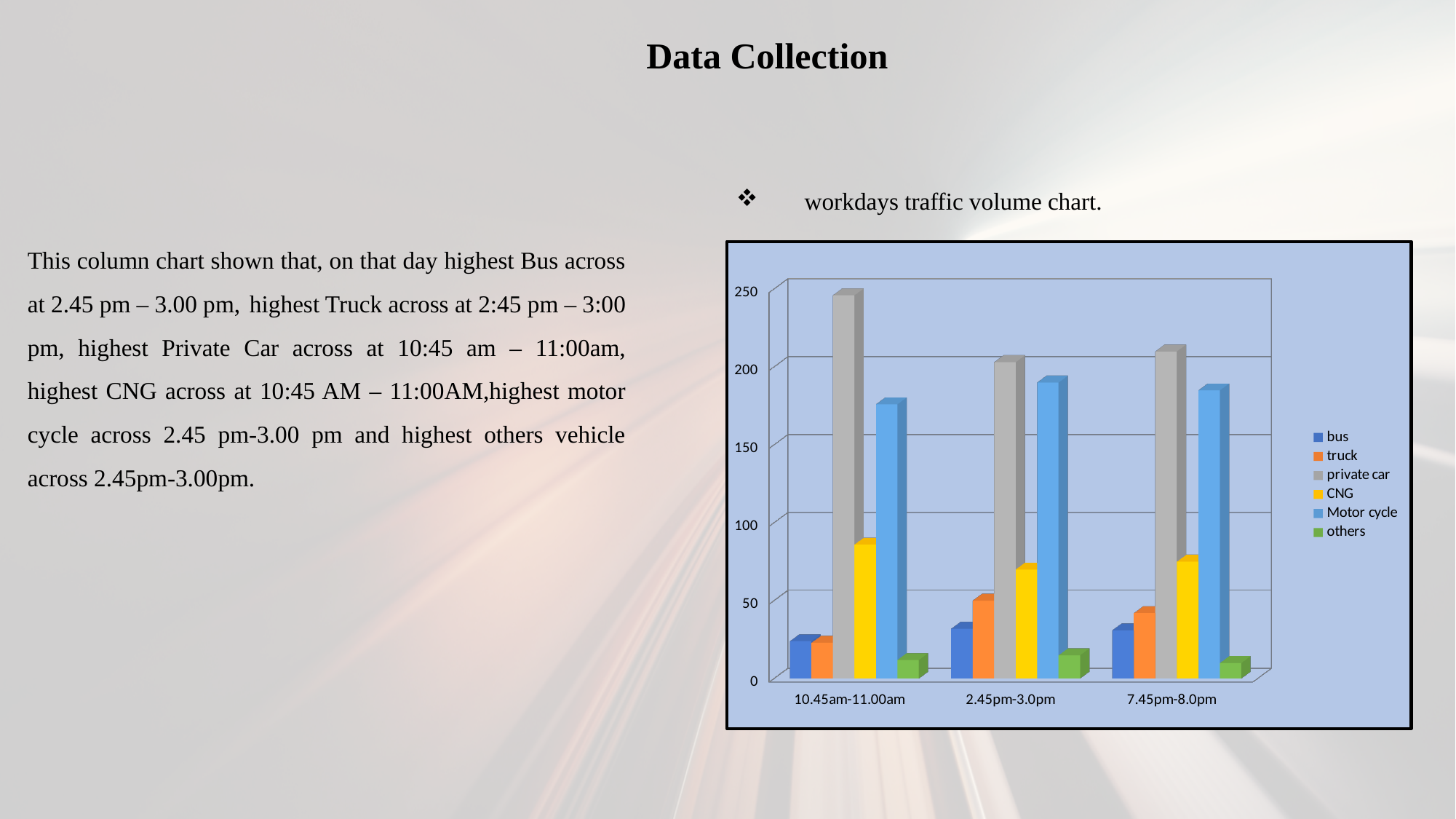
Which is larger in the 7.45pm-8.0pm period, private car or Motor cycle? private car Is the value for Motor cycle in the 2.45pm-3.0pm period greater or less than 150? greater Which series is shown in yellow in the chart's legend? CNG What kind of chart is shown on the slide? bar chart Is the value for private car in the 10.45am-11.00am period greater or less than 200? greater Is the value for CNG in the 10.45am-11.00am period greater or less than 100? less In which time period is the private car value highest? 10.45am-11.00am Which series has the lowest value in the 2.45pm-3.0pm period? others How many time periods are shown on the x axis of the chart? 3 How many series does the chart's legend list? 6 Which series has the highest value in the 10.45am-11.00am period? private car